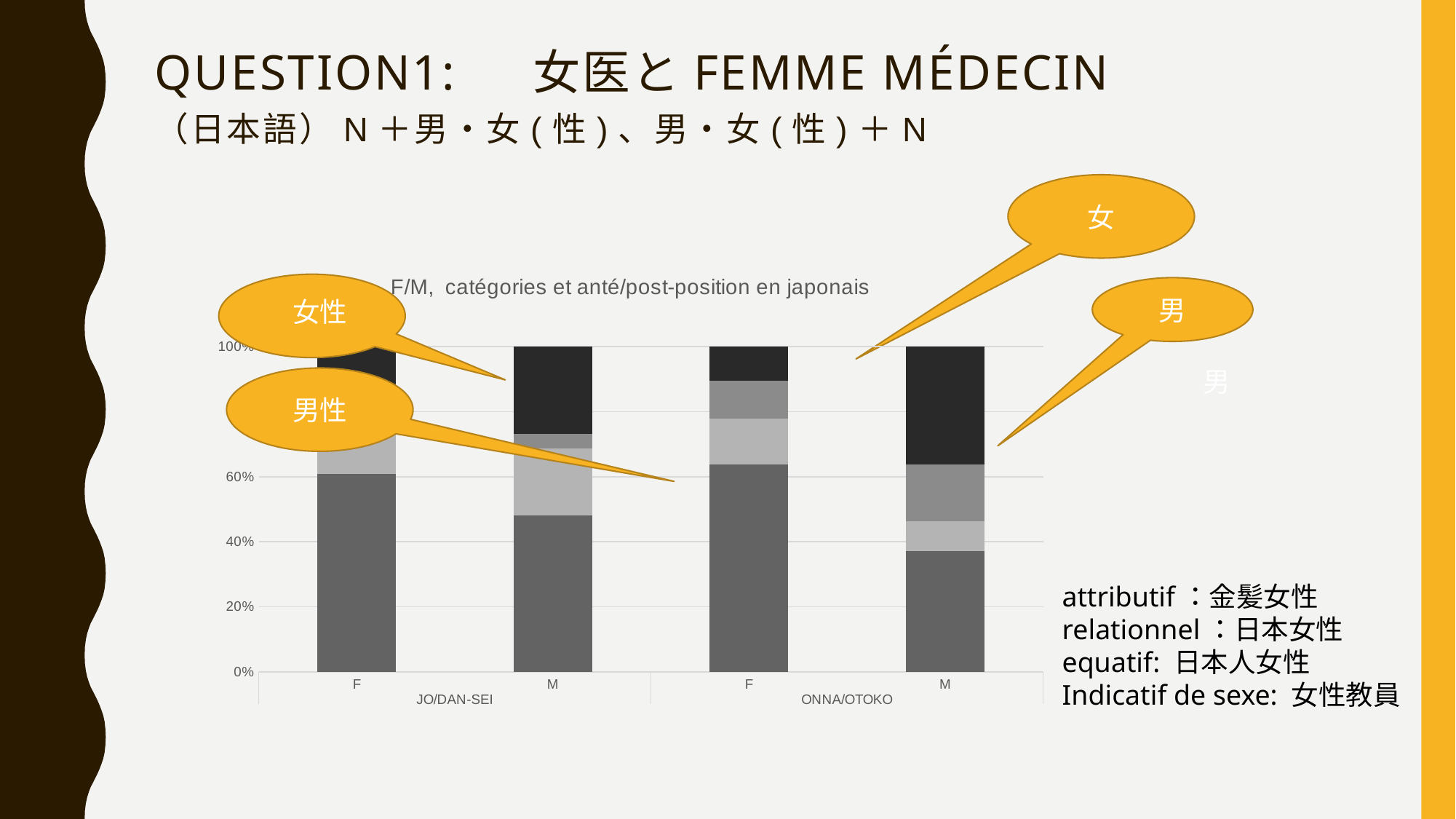
Is the bottom (dark grey) segment of the M bar in the ONNA/OTOKO group greater or less than 40%? less What kind of chart is shown on the slide? stacked bar chart Is the bottom (dark grey) segment of the F bar in the ONNA/OTOKO group greater or less than 60%? greater What is the title of the chart? F/M, catégories et anté/post-position en japonais What is the total height of the F bar in the JO/DAN-SEI group? 100% Is the bottom (dark grey) segment of the M bar in the JO/DAN-SEI group greater or less than 40%? greater Which bar has the smallest bottom (dark grey) segment? M in ONNA/OTOKO How many category groups are shown along the x axis of the chart? 2 How many bars are plotted in the chart? 4 What are the two group labels shown along the x axis of the chart? JO/DAN-SEI and ONNA/OTOKO In the ONNA/OTOKO group, which bar has the larger bottom (dark grey) segment, F or M? F